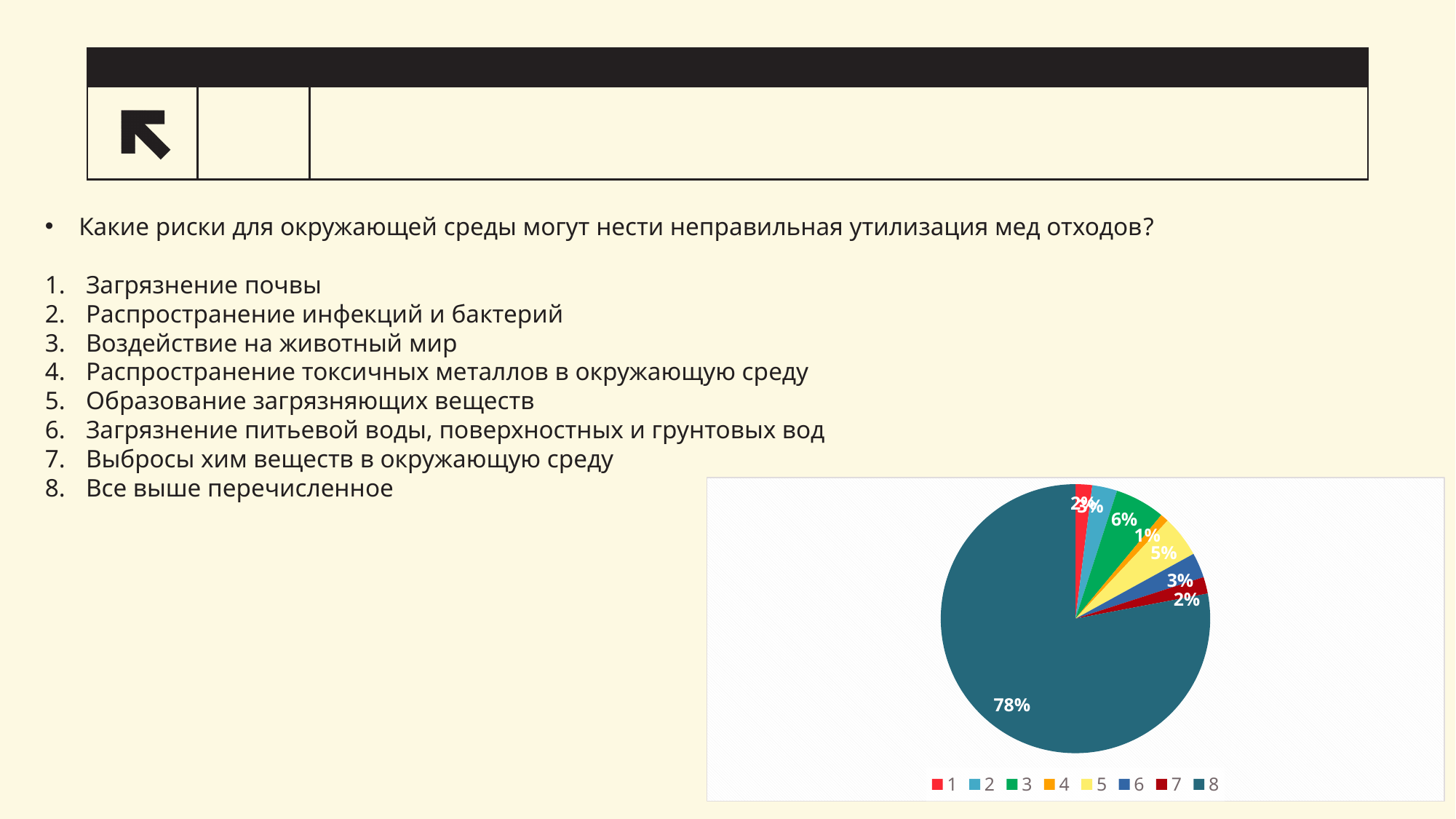
How many entries does the legend of the pie chart list? 8 What share of the pie does category 6 have? 3% What share of the pie does category 4 have? 1% Which category has the largest slice of the pie? 8 Which category has the smallest slice of the pie? 4 How many slices does the pie chart have? 8 What share of the pie does category 8 have? 78% What share of the pie does category 3 have? 6% What share of the pie does category 7 have? 2% By how many percentage points does the share of category 8 exceed the share of category 3? 72% What share of the pie does category 5 have? 5% What kind of chart is shown on the slide? pie chart